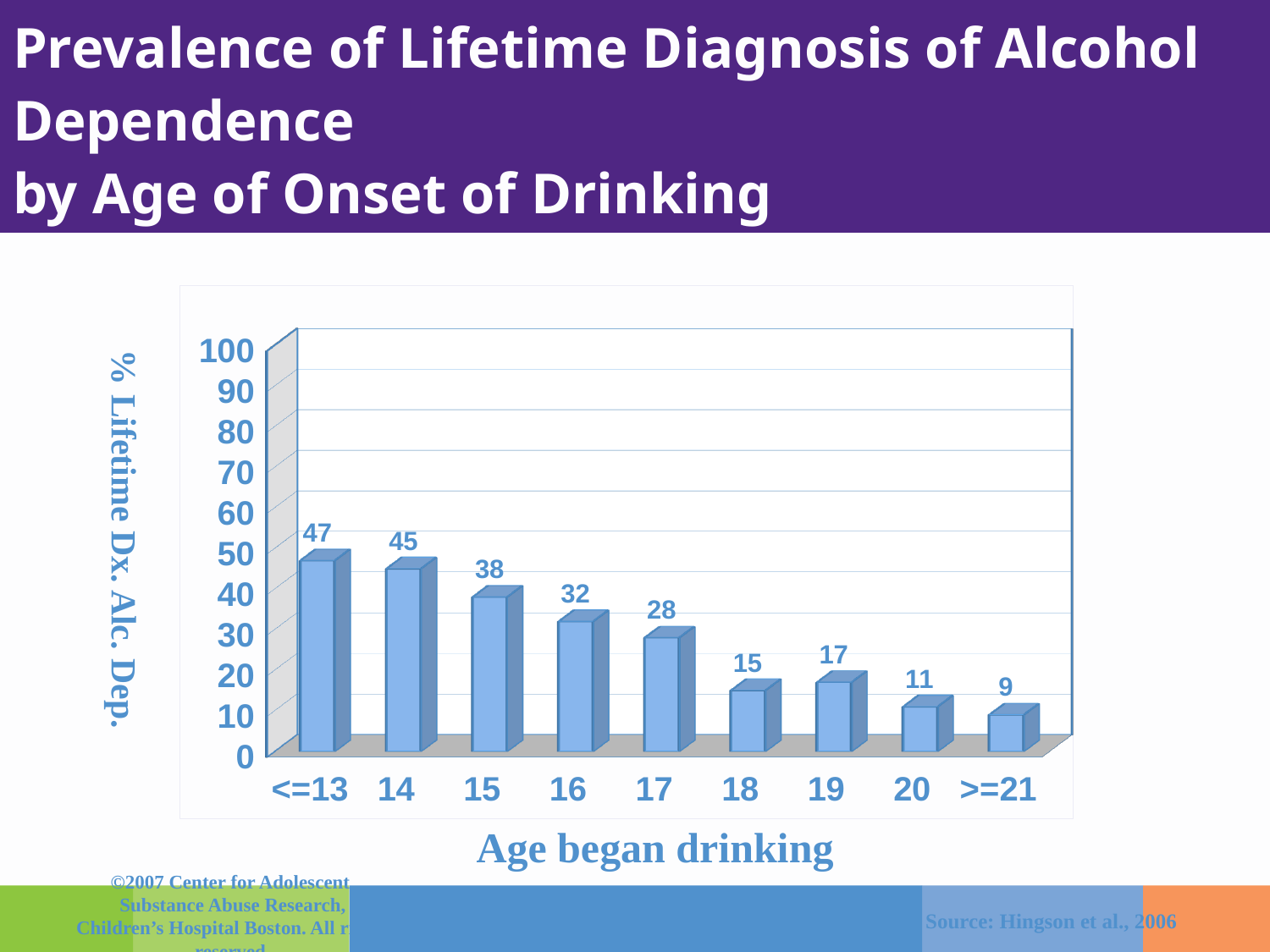
Which age of onset category has the highest % lifetime diagnosis of alcohol dependence? <=13 How many age categories are shown on the x axis? 9 What is the difference between the values for age <=13 and age >=21? 38 What is the label of the x axis? Age began drinking Which age of onset category has the lowest % lifetime diagnosis of alcohol dependence? >=21 What kind of chart is shown on the slide? bar chart Is the value for age 14 greater or less than 40? greater What is the difference between the values for age 15 and age 17? 10 Which is larger, the value for age 18 or the value for age 19? 19 What is the value for age 19 in the chart? 17 What is the % lifetime diagnosis of alcohol dependence for those who began drinking at age <=13? 47 What is the value for age 16 in the chart? 32